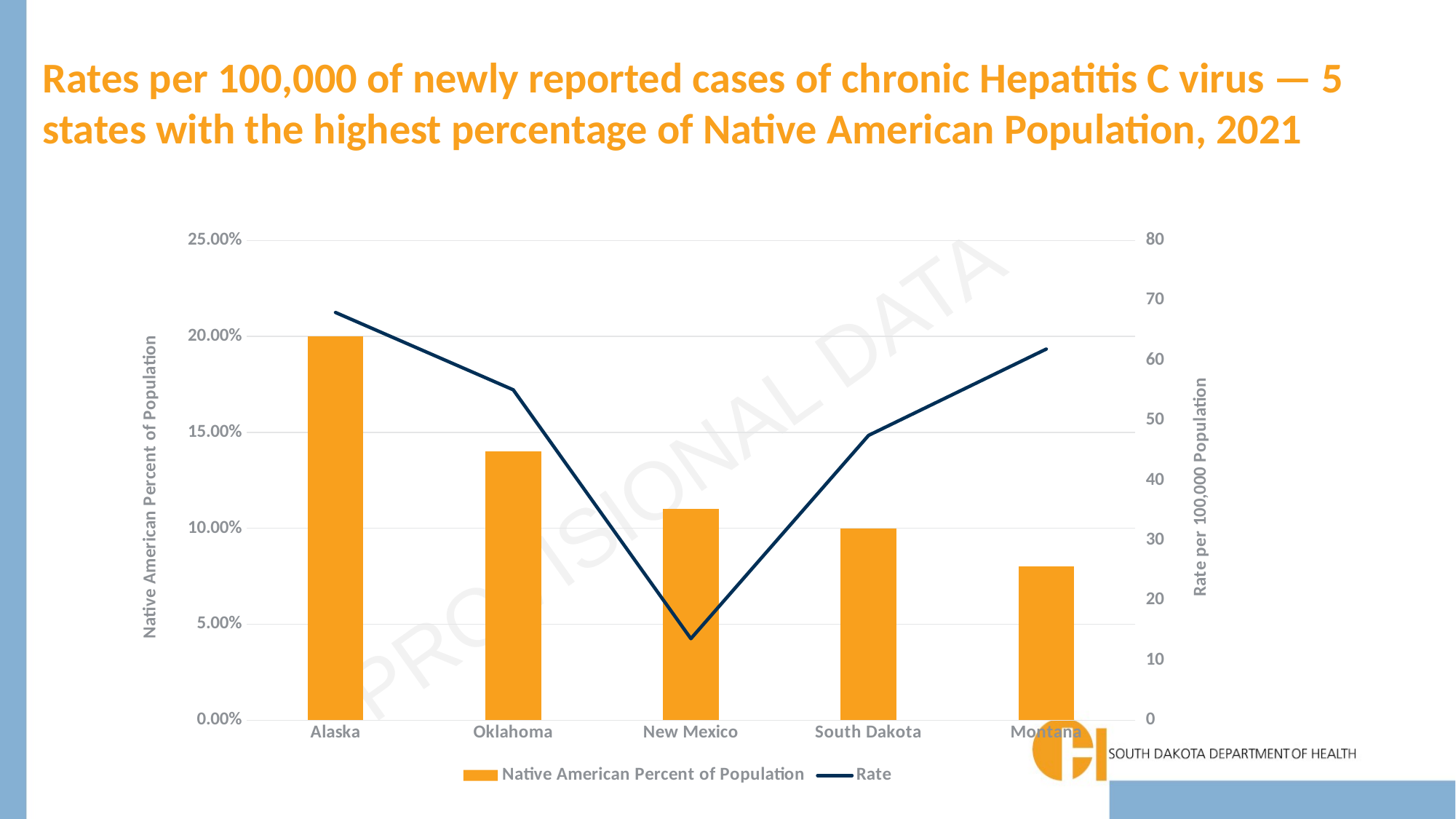
How many states are shown on the x axis of the chart? 5 Which state has the highest Rate on the line series? Alaska Is the Rate for New Mexico greater or less than 20? less Which state has the highest Native American Percent of Population bar? Alaska Is the Native American Percent of Population for Oklahoma greater or less than 15.00%? less Do the Native American Percent of Population bars rise or fall from Alaska to Montana along the x axis? fall What kind of chart is shown on the slide? A bar chart combined with a line How many series does the chart legend list? 2 What are the two series named in the chart legend? Native American Percent of Population and Rate Which state has the larger Native American Percent of Population bar, Oklahoma or South Dakota? Oklahoma Which state has the lowest Rate on the line series? New Mexico Which state has the lowest Native American Percent of Population bar? Montana